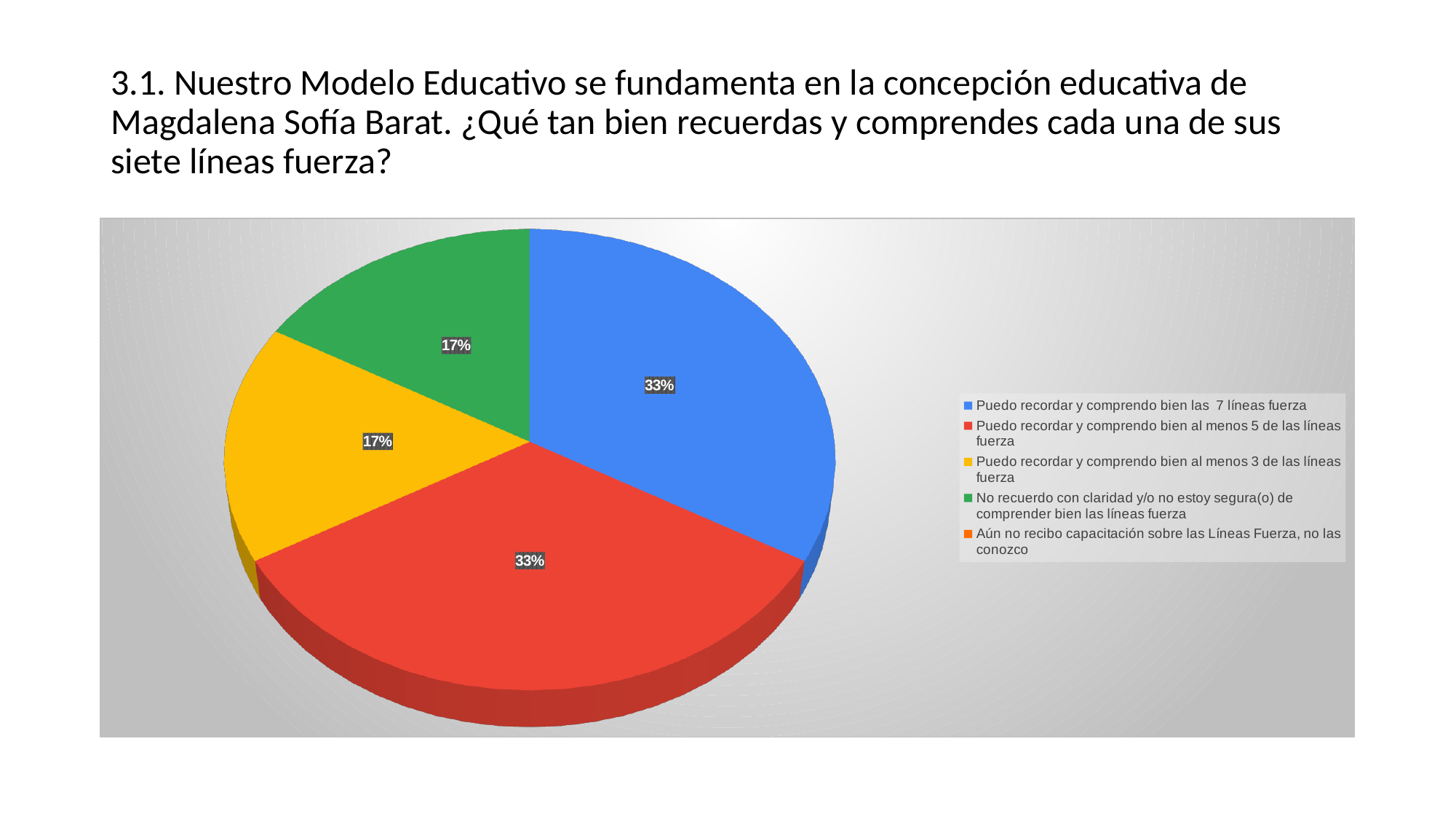
What percentage of the pie corresponds to "Puedo recordar y comprendo bien al menos 5 de las líneas fuerza"? 33% How many slices with data labels are visible in the pie? 4 Which legend entry has no visible slice in the pie? Aún no recibo capacitación sobre las Líneas Fuerza, no las conozco Which is larger: the slice for "Puedo recordar y comprendo bien las 7 líneas fuerza" or the slice for "Puedo recordar y comprendo bien al menos 3 de las líneas fuerza"? Puedo recordar y comprendo bien las 7 líneas fuerza How many entries does the chart legend list? 5 What is the difference in percentage points between the slice for "Puedo recordar y comprendo bien al menos 5 de las líneas fuerza" and the slice for "No recuerdo con claridad y/o no estoy segura(o) de comprender bien las líneas fuerza"? 16 percentage points What colour is the slice for "Puedo recordar y comprendo bien las 7 líneas fuerza"? Blue What percentage of the pie corresponds to "Puedo recordar y comprendo bien al menos 3 de las líneas fuerza"? 17% What percentage of the pie corresponds to "No recuerdo con claridad y/o no estoy segura(o) de comprender bien las líneas fuerza"? 17% What kind of chart is shown on the slide? Pie chart What is the combined percentage of the two 33% slices? 66%